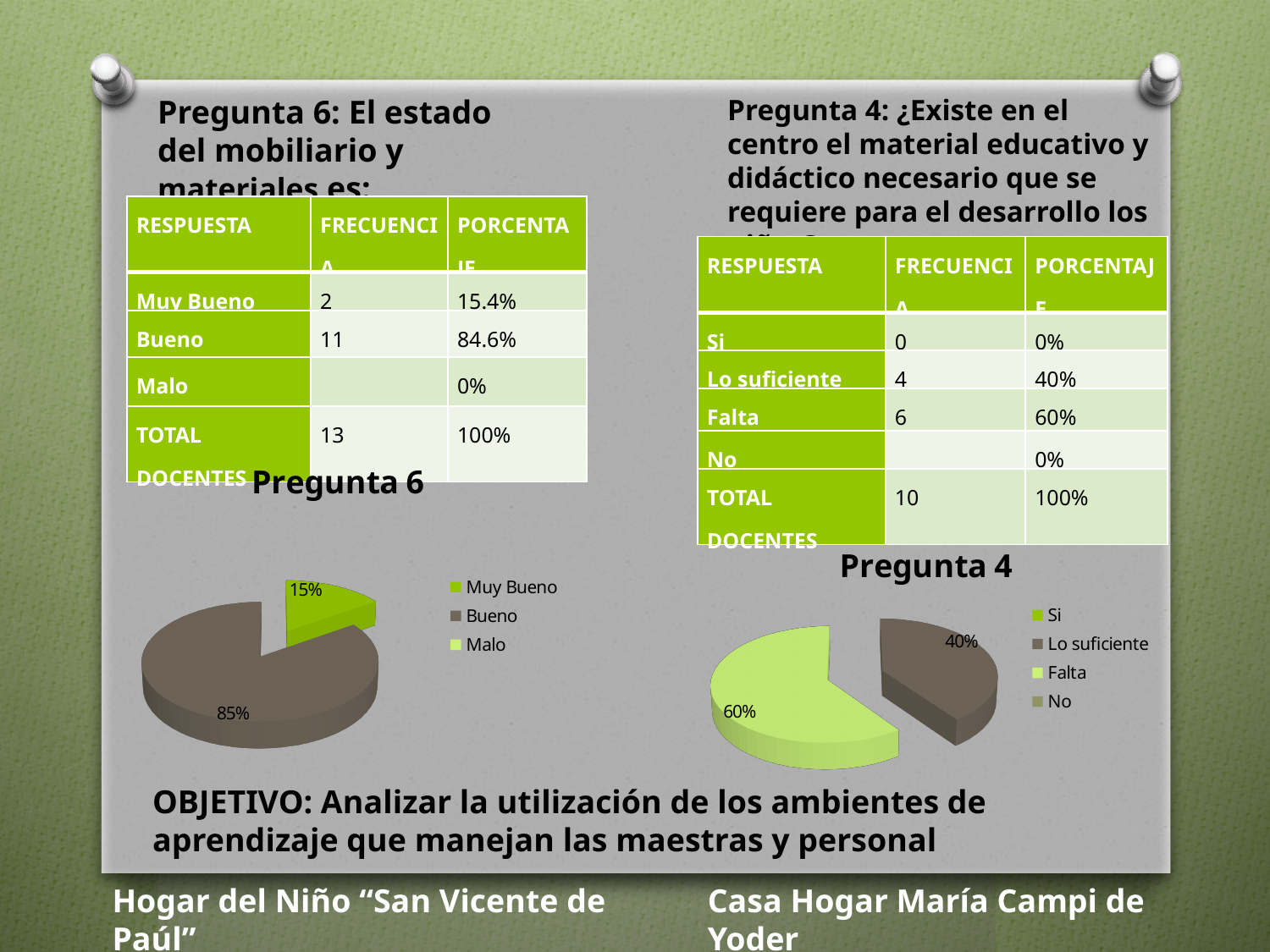
How many entries does the legend of the "Pregunta 4" chart list? 4 In the "Pregunta 6" chart, which category has the largest slice? Bueno In the "Pregunta 4" chart, what share of the pie is labelled for Lo suficiente? 40% What kind of chart is the "Pregunta 4" chart? pie chart In the "Pregunta 4" chart, which slice is larger, Falta or Lo suficiente? Falta In the "Pregunta 6" chart, what share of the pie is labelled for Bueno? 85% In the "Pregunta 4" chart, which category has the largest slice? Falta In the "Pregunta 6" chart, what is the difference between the Bueno and Muy Bueno percentages shown on the chart? 70% In the "Pregunta 4" chart, what share of the pie is labelled for Falta? 60% What kind of chart is the "Pregunta 6" chart? pie chart How many entries does the legend of the "Pregunta 6" chart list? 3